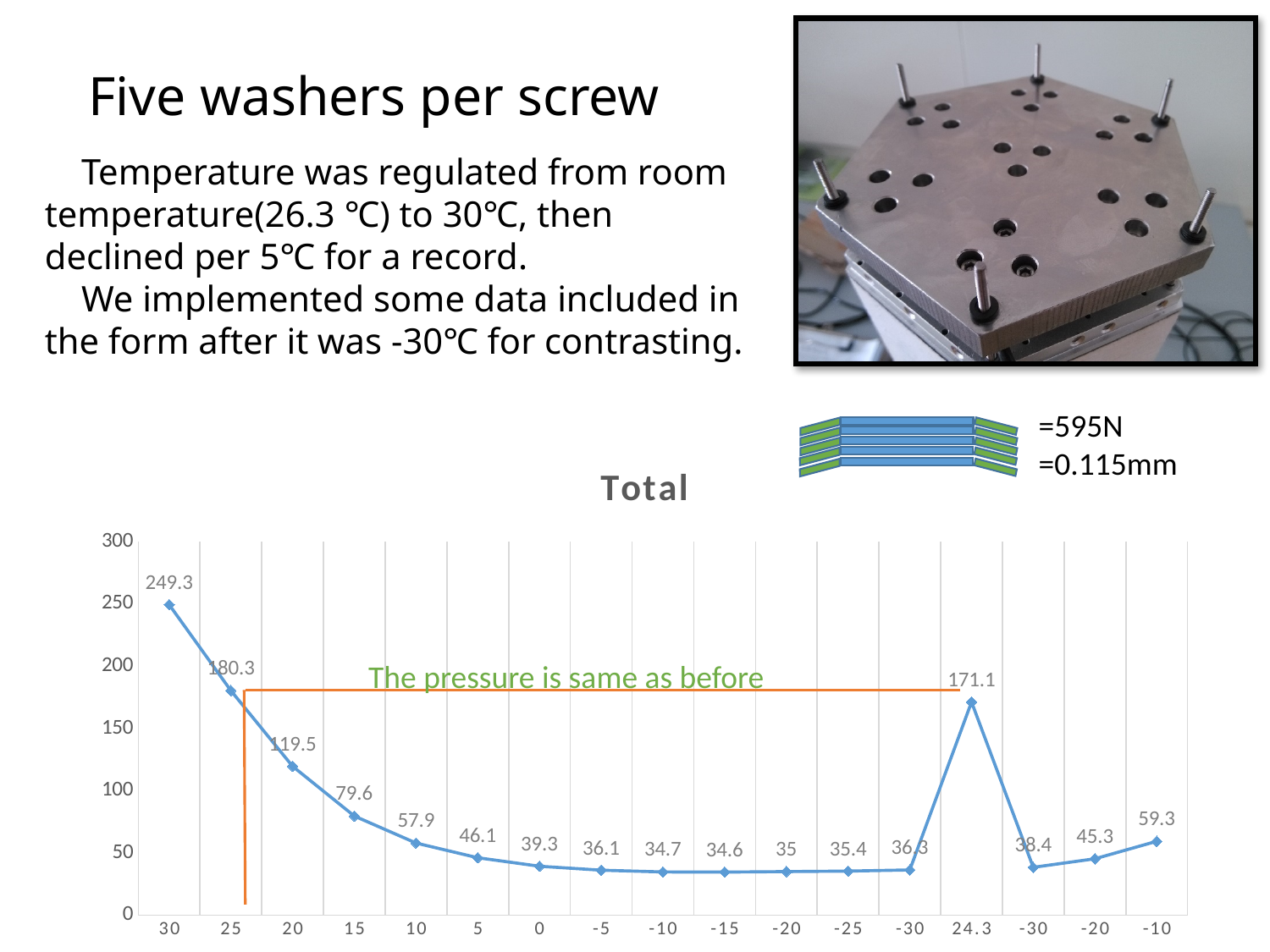
What is the value plotted at x = 5 on the Total chart? 46.1 Which has the larger value on the Total chart, x = 25 or x = 20? 25 Which x-axis category has the highest value on the Total chart? 30 Is the value at x = 15 on the Total chart greater or less than 100? less What is the value plotted at x = 30 on the Total chart? 249.3 What is the title of the chart on the slide? Total What is the difference between the values at x = 24.3 and x = 20 on the Total chart? 51.6 What kind of chart is shown on the slide? line chart What is the value plotted at x = 0 on the Total chart? 39.3 What is the value plotted at x = 24.3 on the Total chart? 171.1 What is the difference between the values at x = 30 and x = 25 on the Total chart? 69 How many data points are plotted on the Total chart? 17